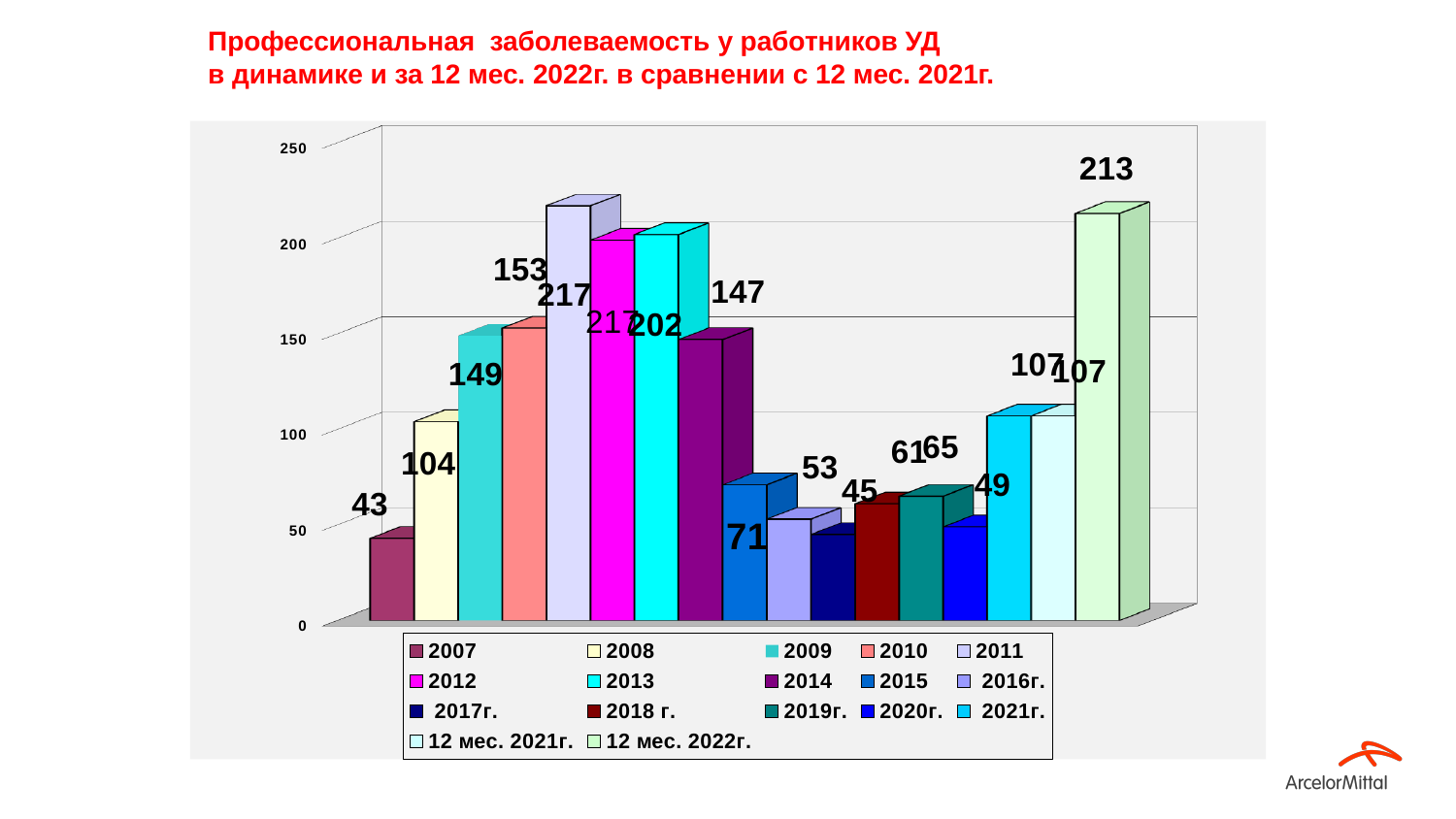
What is the value for 2010? 153 What is the value for 2008? 104 Which is larger, the value for 2008 or the value for 2015? 2008 What is the difference between the values for 2008 and 2007? 61 What is the value for 2020г.? 49 What is the value for 2015? 71 What is the difference between the values for 12 мес. 2022г. and 12 мес. 2021г.? 106 What kind of chart is shown on the slide? bar chart How many series does the legend list? 17 What is the value for 12 мес. 2022г.? 213 What is the value for 2007? 43 Is the value for 2014 greater or less than 100? greater